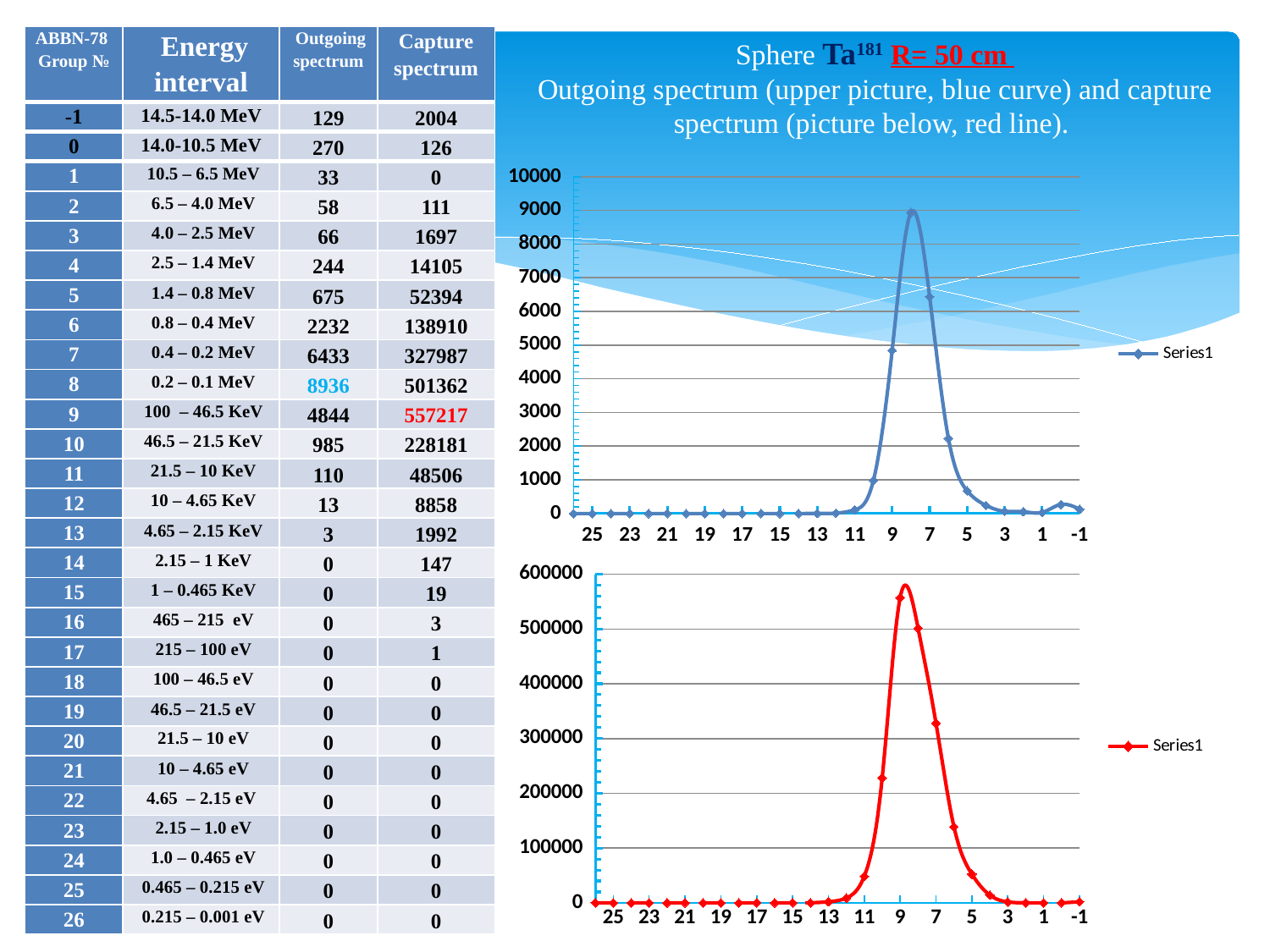
How many series does the legend of the lower chart list? 1 In the lower chart, which is larger: the value at group 9 or the value at group 7? group 9 In the upper chart, is the value at group 5 greater or less than 1000? less What type of chart is the upper chart on the slide? line chart What is the name of the series shown in the legend of the upper chart? Series1 In the upper chart, does the curve rise or fall as the x axis goes from group 11 to group 8? rise In the upper chart, is the value at group 9 greater or less than 4000? greater In the upper chart (blue curve), at which x-axis group does the curve reach its highest value? 8 In the lower chart (red curve), at which x-axis group does the curve reach its highest value? 9 In the lower chart, is the value at group 11 greater or less than 100000? less In the upper chart, which is larger: the value at group 9 or the value at group 7? group 7